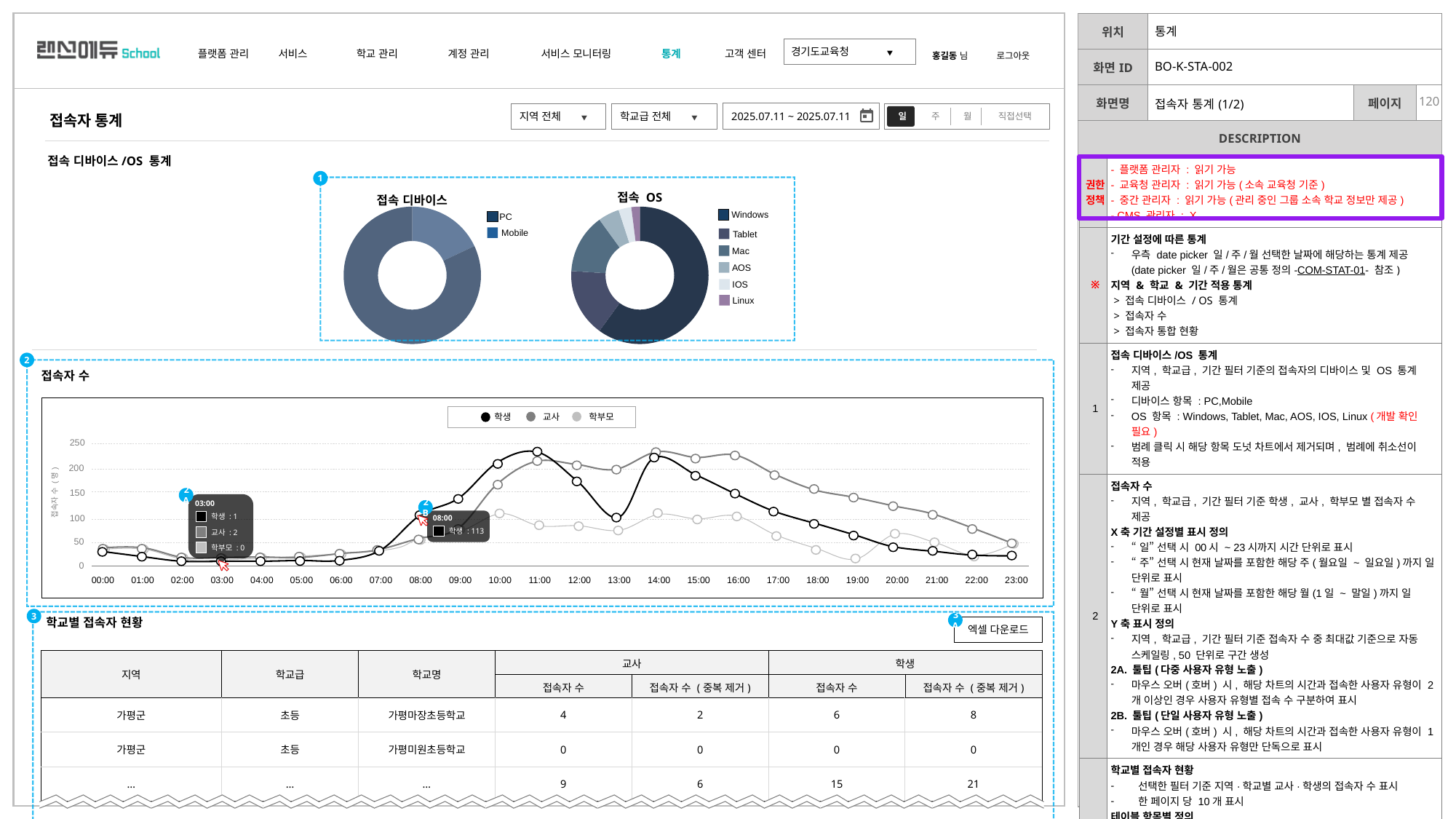
In the 접속 디바이스 donut chart, how many entries does the legend list? 2 In the 접속자 수 line chart, how many time points are shown on the x axis? 24 In the 접속 OS donut chart, how many entries does the legend list? 6 What kind of chart is the 접속자 수 chart? line chart In the 접속 OS donut chart, which OS has the largest share? Windows In the 접속자 수 line chart, what is the 교사 value shown in the tooltip at 03:00? 2 In the 접속 디바이스 donut chart, which category has the larger share, PC or Mobile? PC In the 접속자 수 line chart, does the 학생 line rise or fall from 08:00 to 11:00? rise In the 접속자 수 line chart, is the 학생 value at 11:00 greater or less than 200? greater In the 접속자 수 line chart, what is the 학생 value shown in the tooltip at 08:00? 113 In the 접속자 수 line chart, at 03:00 which is larger, 학생 or 교사? 교사 In the 접속자 수 line chart, how many series does the legend list? 3